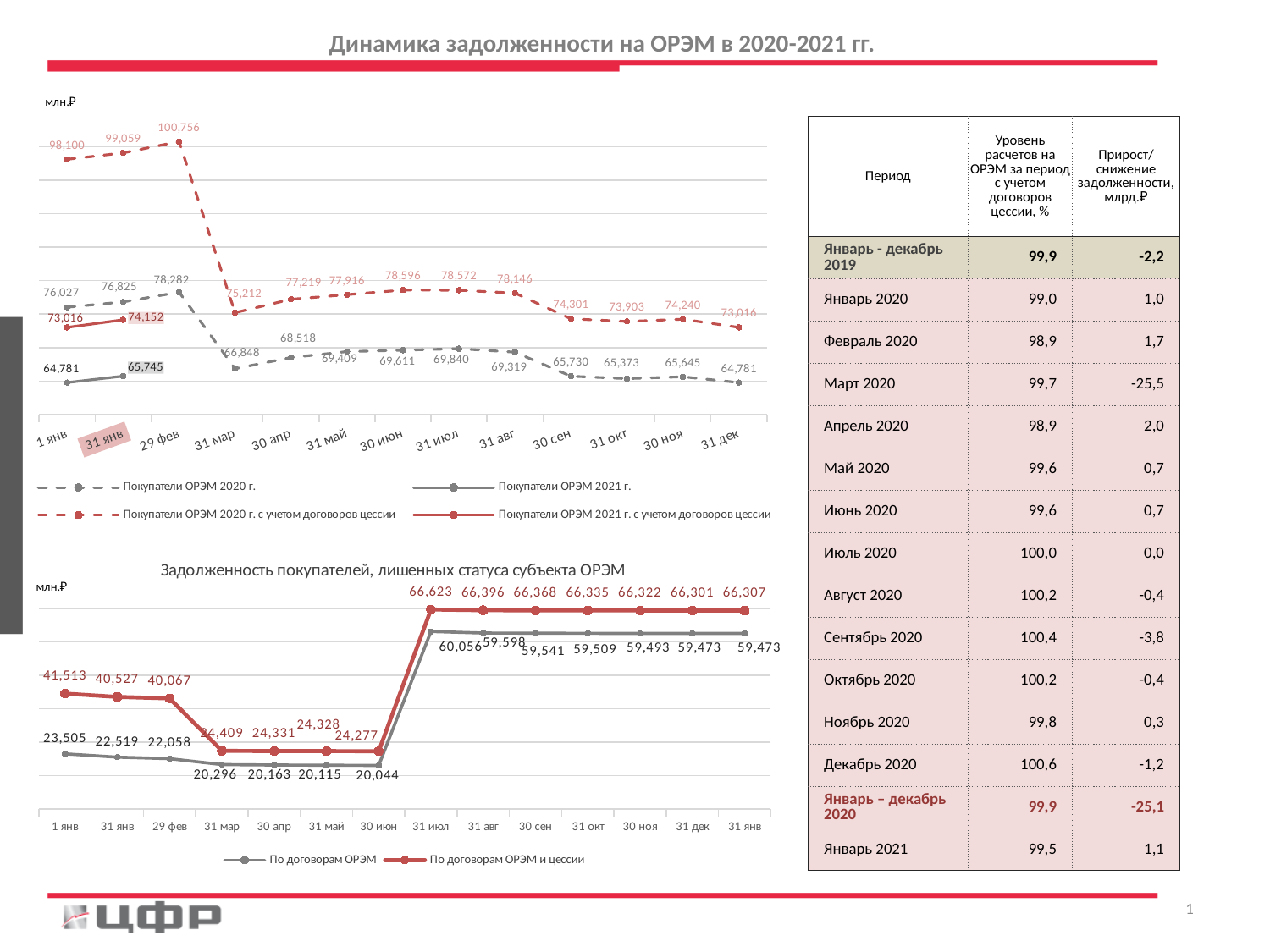
On the top chart, what is the value for Покупатели ОРЭМ 2021 г. at 31 янв? 65,745 On the top chart, at which date does the series Покупатели ОРЭМ 2020 г. reach its highest value? 29 фев On the top chart, how many series does the legend list? 4 On the chart 'Задолженность покупателей, лишенных статуса субъекта ОРЭМ', what is the difference between По договорам ОРЭМ и цессии and По договорам ОРЭМ at 31 янв (the last point)? 6,834 On the chart 'Задолженность покупателей, лишенных статуса субъекта ОРЭМ', what is the value for По договорам ОРЭМ и цессии at 31 июл? 66,623 On the chart 'Задолженность покупателей, лишенных статуса субъекта ОРЭМ', which is larger at 1 янв: По договорам ОРЭМ or По договорам ОРЭМ и цессии? По договорам ОРЭМ и цессии On the top chart, what is the value for Покупатели ОРЭМ 2020 г. с учетом договоров цессии at 29 фев? 100,756 On the chart 'Задолженность покупателей, лишенных статуса субъекта ОРЭМ', does the value for По договорам ОРЭМ rise or fall from 1 янв to 30 июн? fall What kind of chart is the chart titled 'Задолженность покупателей, лишенных статуса субъекта ОРЭМ'? line chart On the top chart, how many dates are shown on the x axis? 13 On the top chart, what is the difference between the Покупатели ОРЭМ 2020 г. с учетом договоров цессии values at 29 фев and 31 мар? 25,544 On the chart 'Задолженность покупателей, лишенных статуса субъекта ОРЭМ', at which date is the value for По договорам ОРЭМ lowest? 30 июн